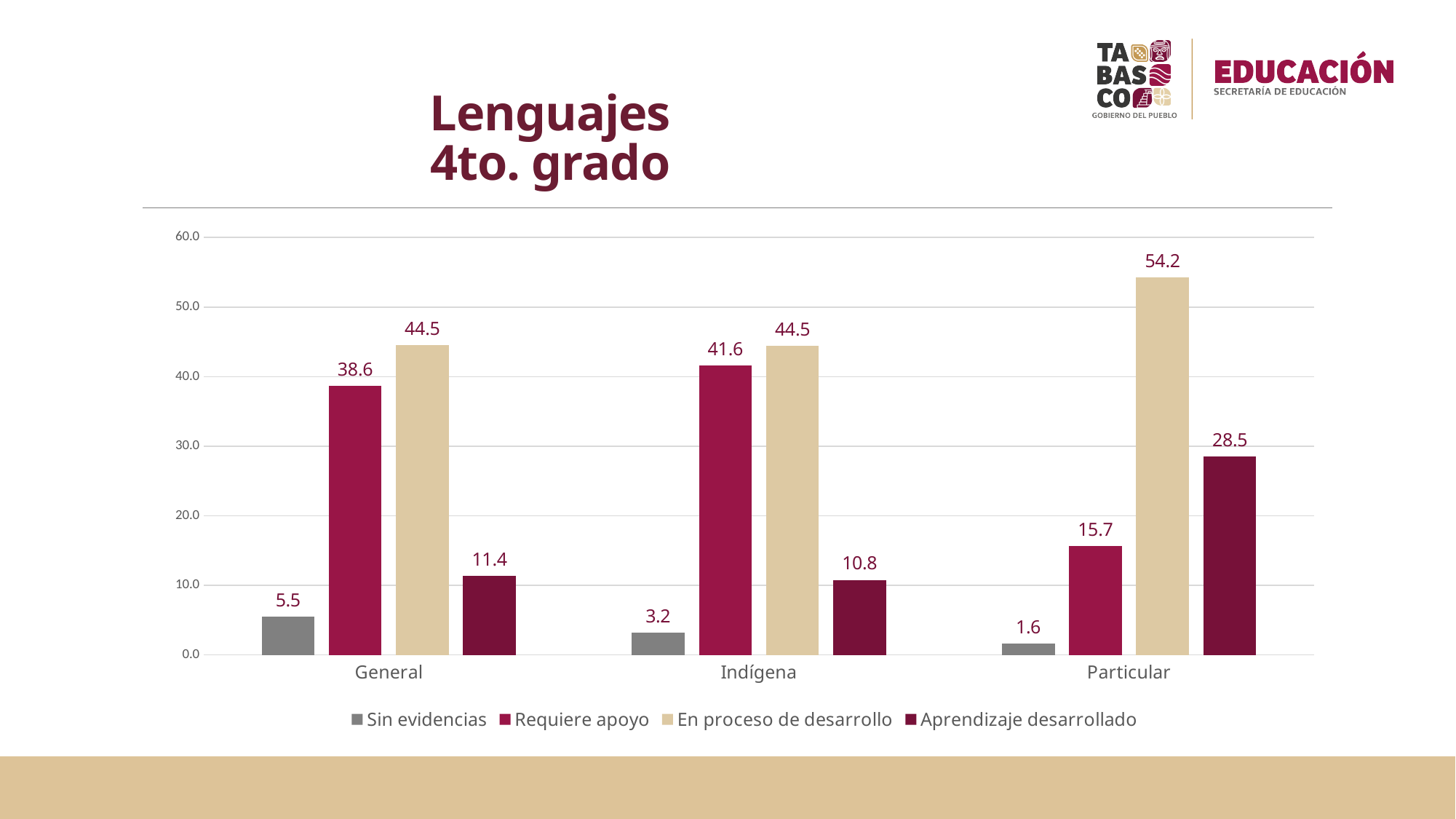
How many categories are shown on the x axis? 3 How many series does the legend list? 4 Is the value for "En proceso de desarrollo" in the Particular category greater or less than 50.0? greater What is the value for "Requiere apoyo" in the Indígena category? 41.6 What is the difference between the "Aprendizaje desarrollado" values for Particular and Indígena? 17.7 What is the difference between the "Requiere apoyo" values for Indígena and General? 3.0 What is the value for "Sin evidencias" in the General category? 5.5 What is the value for "En proceso de desarrollo" in the Particular category? 54.2 Which category has the highest value for "Aprendizaje desarrollado"? Particular What kind of chart is shown on the slide? Bar chart Which category has the lowest value for "Sin evidencias"? Particular Which is larger: "Requiere apoyo" for General or "Requiere apoyo" for Particular? General